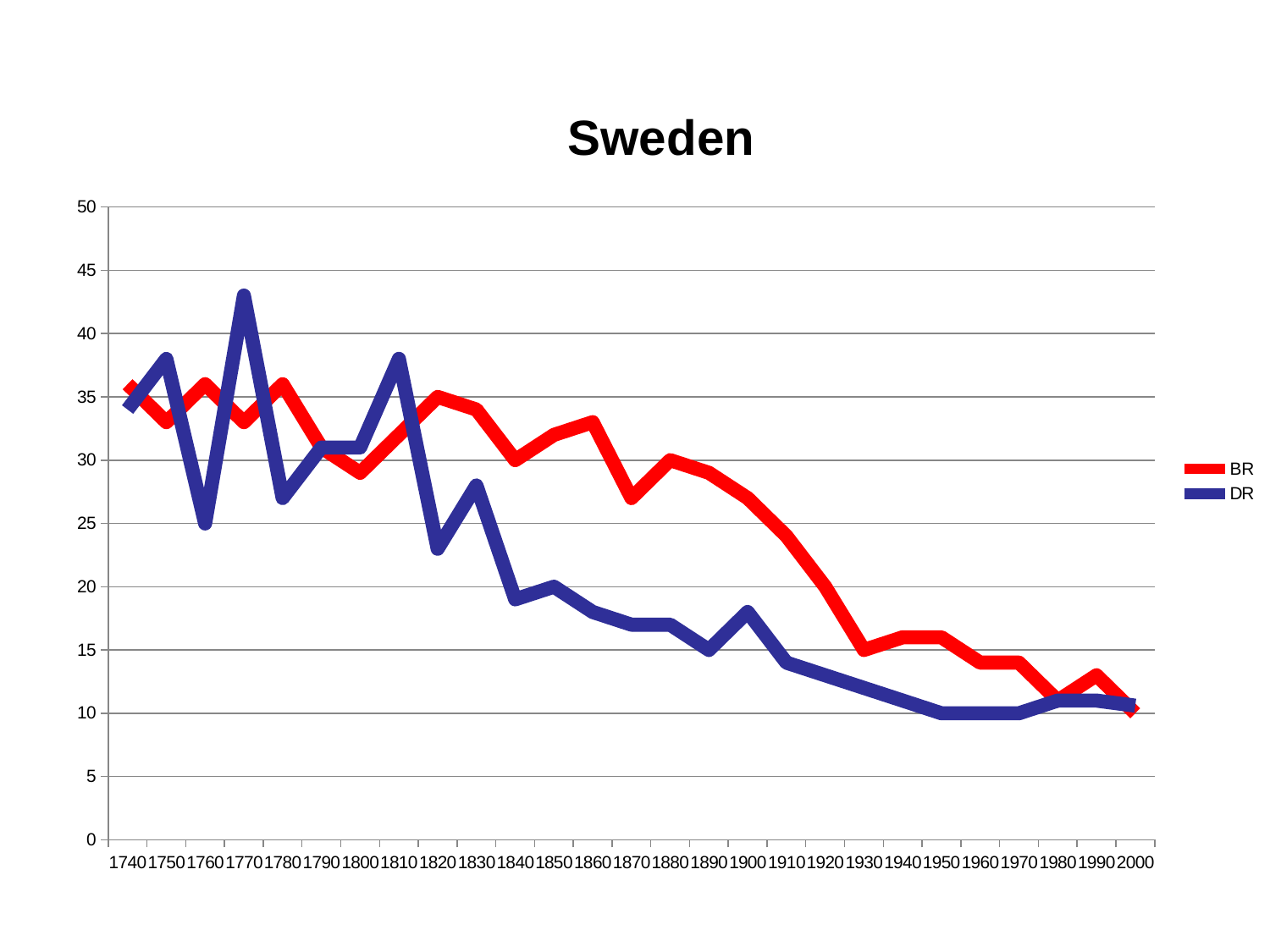
Is the BR value for 1910 greater or less than 20? greater How many series does the legend list? 2 What kind of chart is shown on the slide? line chart What is the title of the chart? Sweden Which series is drawn in blue? DR Overall, does the BR series rise or fall from 1740 to 2000? fall In which year does the DR series reach its highest value? 1770 Is the DR value for 1820 greater or less than 25? less Is the DR value for 1770 greater or less than 40? greater How many years are shown along the x axis? 27 In 1900, which series has the larger value, BR or DR? BR